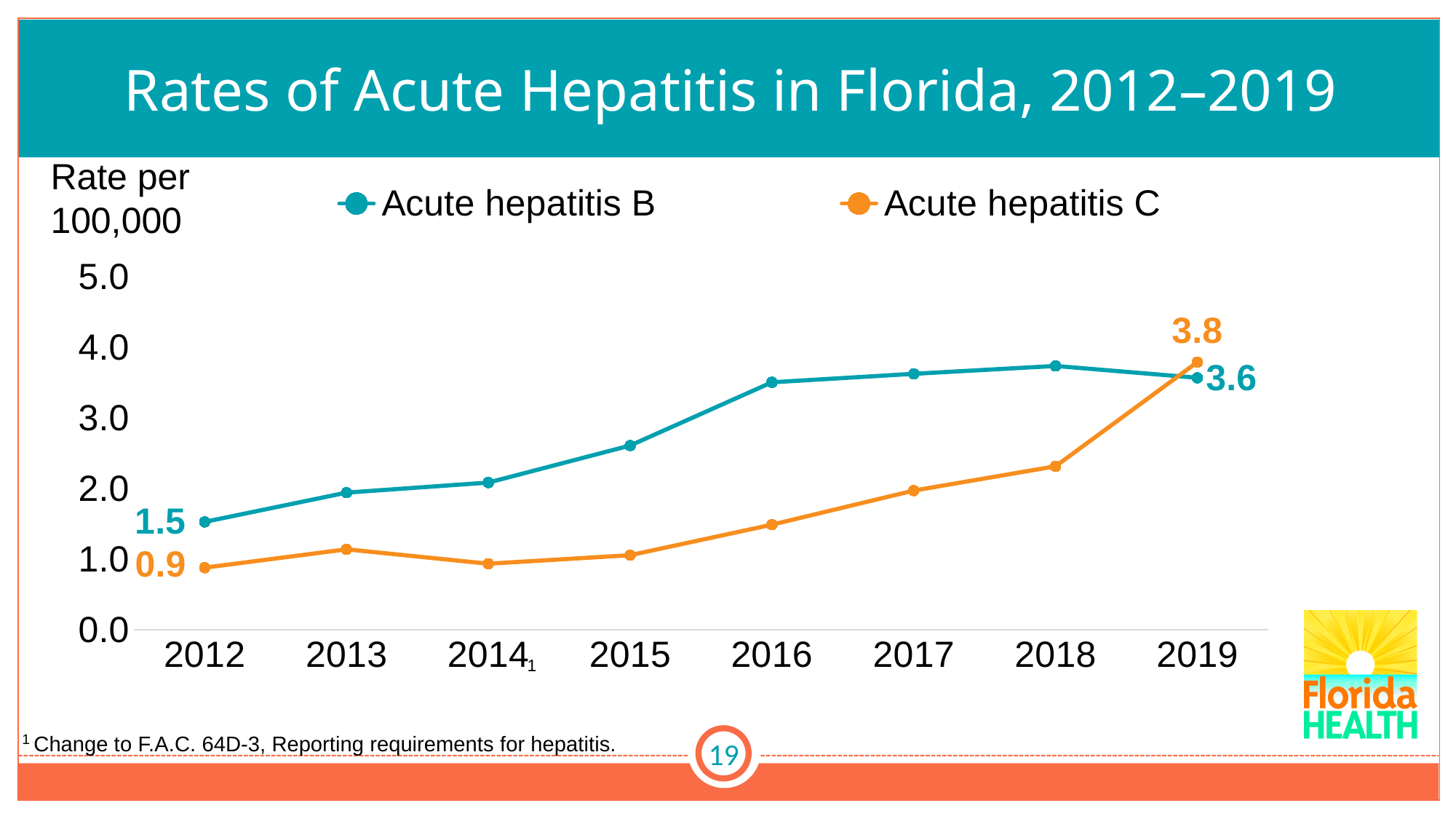
Is the acute hepatitis C rate in 2018 greater or less than 2.0? greater What is the rate of acute hepatitis C in 2012? 0.9 By how much did the acute hepatitis C rate increase from 2012 to 2019? 2.9 What is the rate of acute hepatitis B in 2012? 1.5 How many years are shown on the x axis? 8 What is the rate of acute hepatitis B in 2019? 3.6 What is the y-axis label of the chart? Rate per 100,000 What kind of chart is shown on the slide? Line chart How many series does the legend list? 2 In 2019, which series has the higher rate, acute hepatitis B or acute hepatitis C? Acute hepatitis C What is the rate of acute hepatitis C in 2019? 3.8 Is the acute hepatitis B rate in 2016 greater or less than 3.0? greater